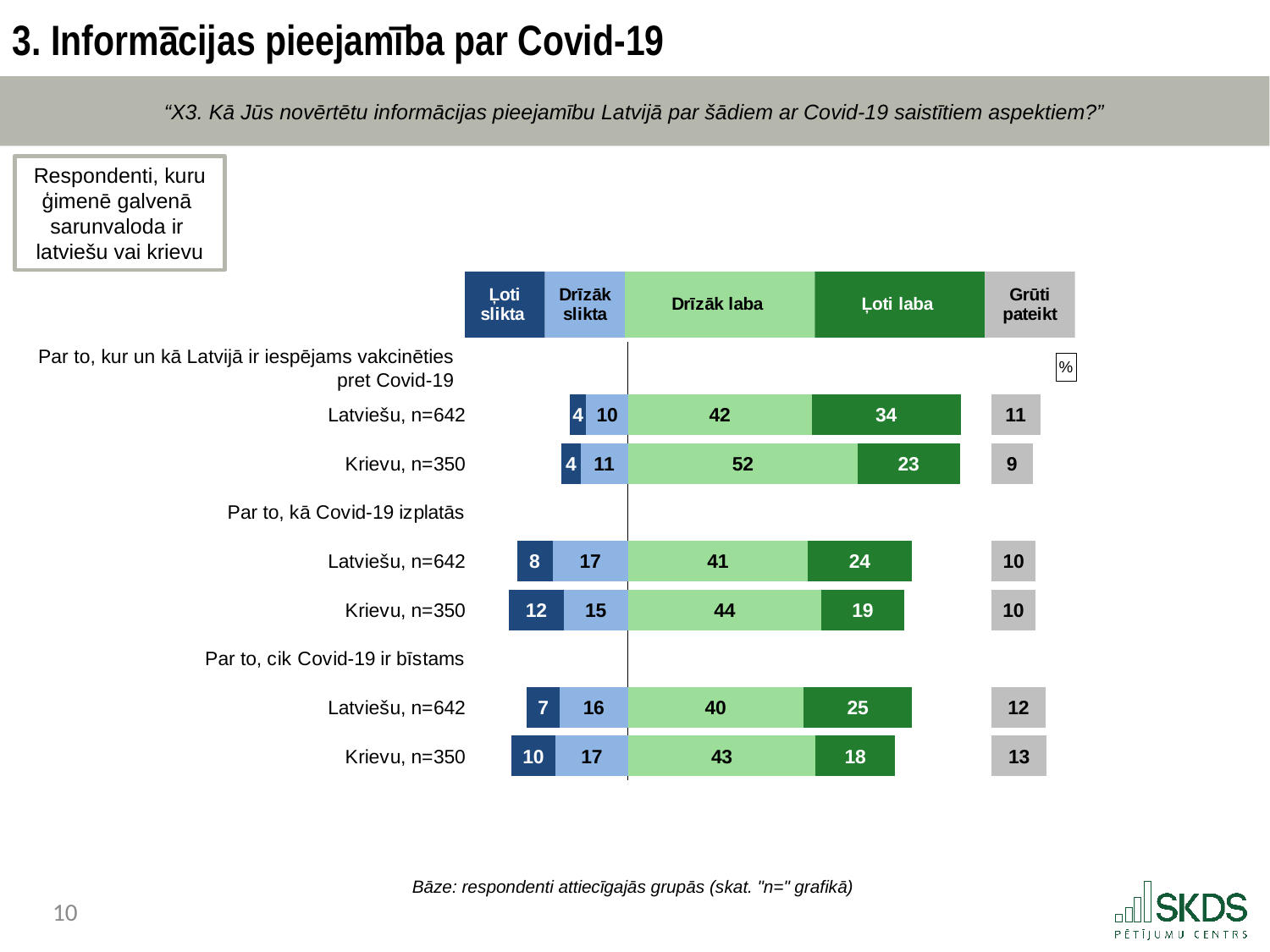
What is the "Ļoti laba" value for Latviešu, n=642 under "Par to, kur un kā Latvijā ir iespējams vakcinēties pret Covid-19"? 34 Which row has the lowest "Ļoti laba" value? Krievu, n=350 (Par to, cik Covid-19 ir bīstams) What is the "Grūti pateikt" value for Krievu, n=350 under "Par to, cik Covid-19 ir bīstams"? 13 Under "Par to, kā Covid-19 izplatās", which group has the larger "Drīzāk slikta" value, Latviešu, n=642 or Krievu, n=350? Latviešu, n=642 What is the "Ļoti slikta" value for Krievu, n=350 under "Par to, kā Covid-19 izplatās"? 12 How many series does the legend list? 5 What kind of chart is shown on the slide? Stacked bar chart Which row has the highest "Drīzāk laba" value? Krievu, n=350 (Par to, kur un kā Latvijā ir iespējams vakcinēties pret Covid-19) What is the "Drīzāk laba" value for Krievu, n=350 under "Par to, kur un kā Latvijā ir iespējams vakcinēties pret Covid-19"? 52 What is the difference between the "Ļoti laba" values for Latviešu, n=642 and Krievu, n=350 under "Par to, kur un kā Latvijā ir iespējams vakcinēties pret Covid-19"? 11 What is the total of "Ļoti slikta" and "Drīzāk slikta" for Krievu, n=350 under "Par to, cik Covid-19 ir bīstams"? 27 What colour represents the "Ļoti laba" series in the legend? Dark green